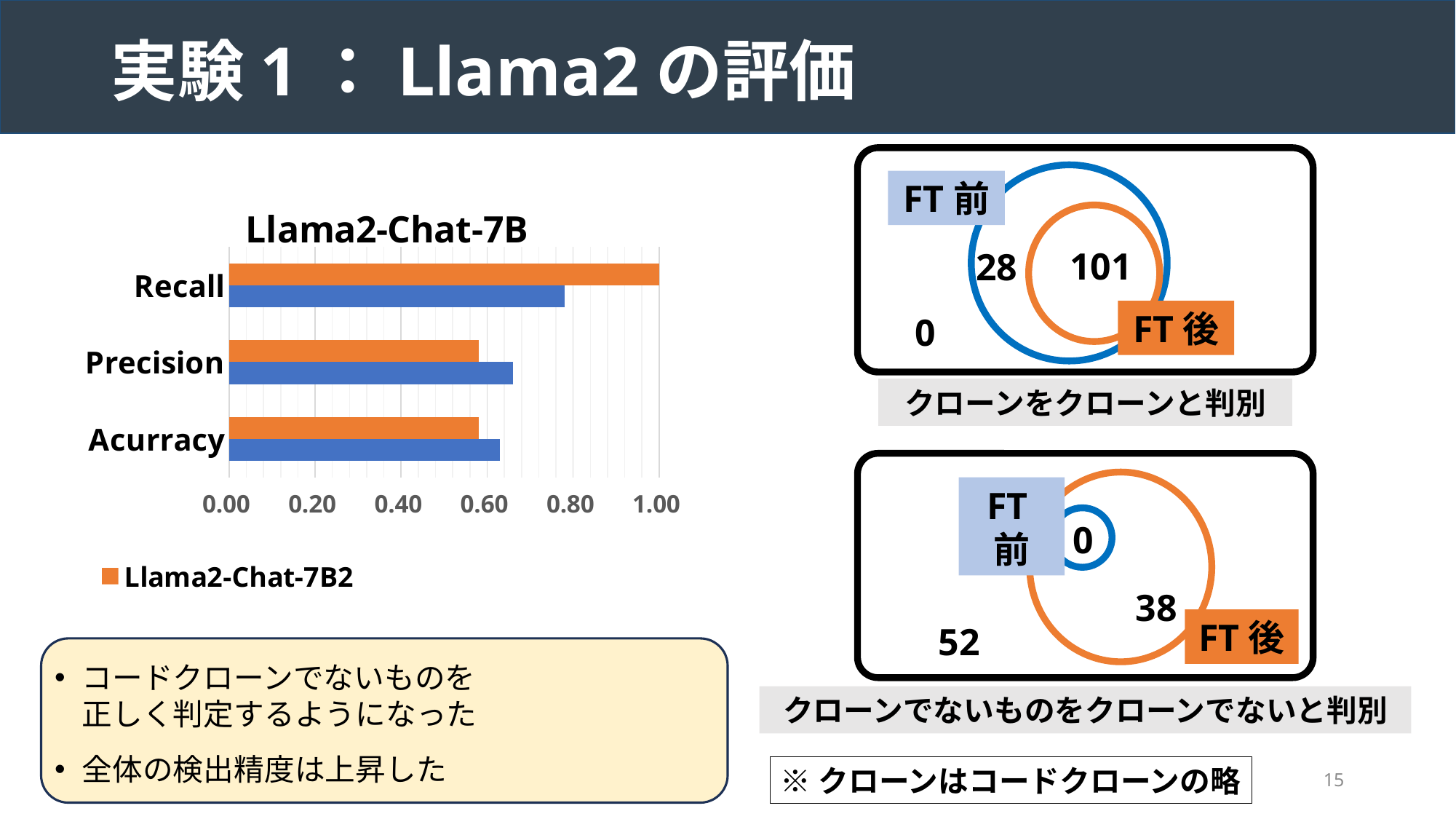
In the Llama2-Chat-7B chart, for Precision, which bar is larger, the orange or the blue? blue In the Llama2-Chat-7B chart, for Recall, which bar is larger, the orange or the blue? orange In the Llama2-Chat-7B chart, is the orange Recall value greater or less than 0.80? greater How many series does the legend of the Llama2-Chat-7B chart list? 1 In the Llama2-Chat-7B chart, which category has the highest value for the blue series? Recall In the Llama2-Chat-7B chart, is the orange Precision value greater or less than 0.60? less How many categories are shown on the y axis of the Llama2-Chat-7B chart? 3 In the Llama2-Chat-7B chart, is the blue Recall value greater or less than 0.60? greater What is the legend entry shown below the Llama2-Chat-7B chart? Llama2-Chat-7B2 What kind of chart is the Llama2-Chat-7B chart? bar chart What is the title of the bar chart on the slide? Llama2-Chat-7B In the Llama2-Chat-7B chart, which category has the highest value for the orange series? Recall